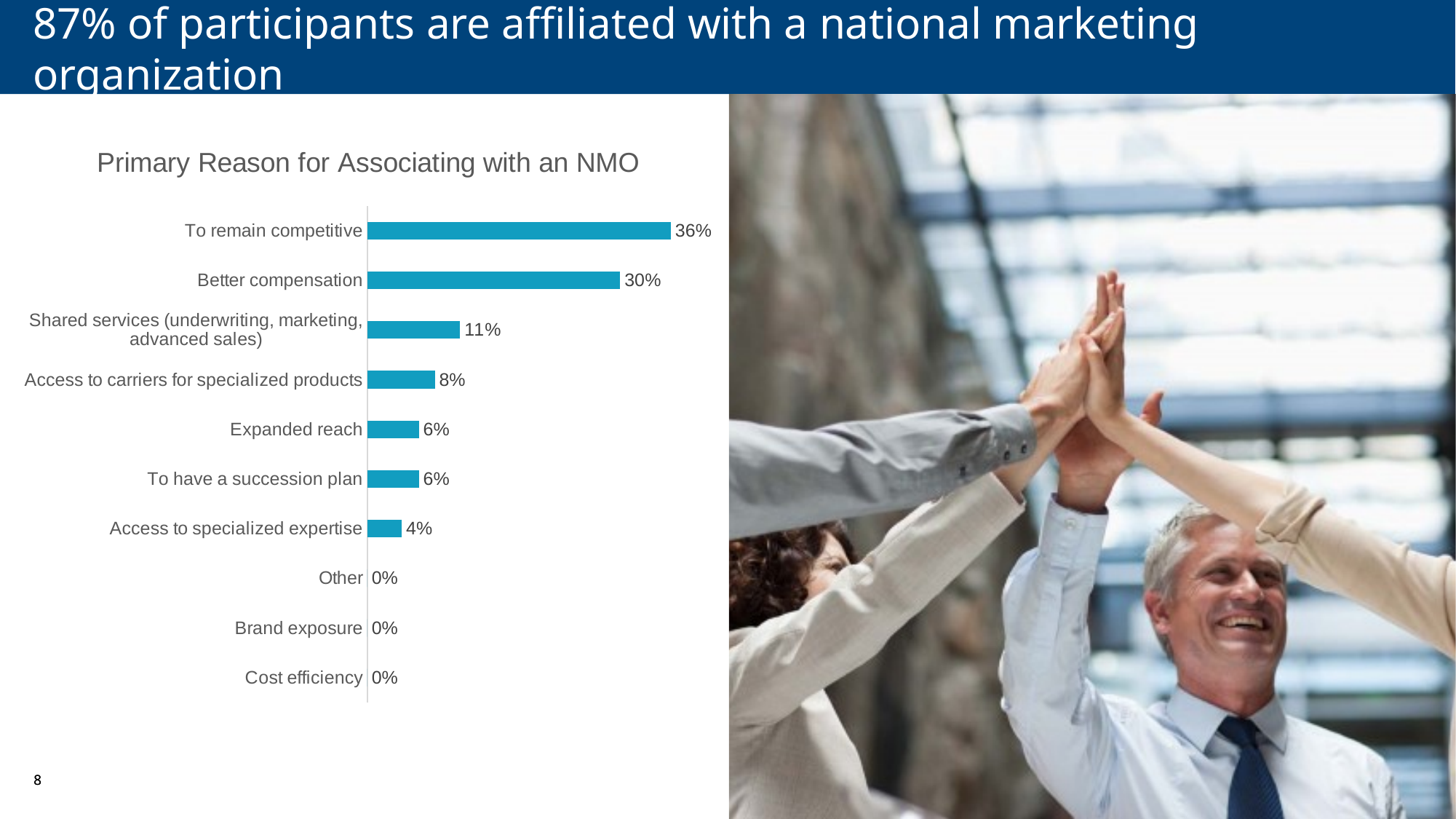
What percentage is shown for 'Shared services (underwriting, marketing, advanced sales)'? 11% What is the title of the chart? Primary Reason for Associating with an NMO What type of chart is shown on the slide? Bar chart How many categories have a value of 0%? 3 What is the value for 'Access to specialized expertise'? 4% What percentage of participants cited 'To remain competitive' as their primary reason for associating with an NMO? 36% Which reason has the highest percentage in the chart? To remain competitive Which is larger: 'Access to carriers for specialized products' or 'Expanded reach'? Access to carriers for specialized products What is the value shown for 'Better compensation'? 30% How many categories are shown in the chart? 10 What is the difference between 'To remain competitive' and 'Better compensation'? 6% What is the difference between 'Shared services (underwriting, marketing, advanced sales)' and 'Access to carriers for specialized products'? 3%